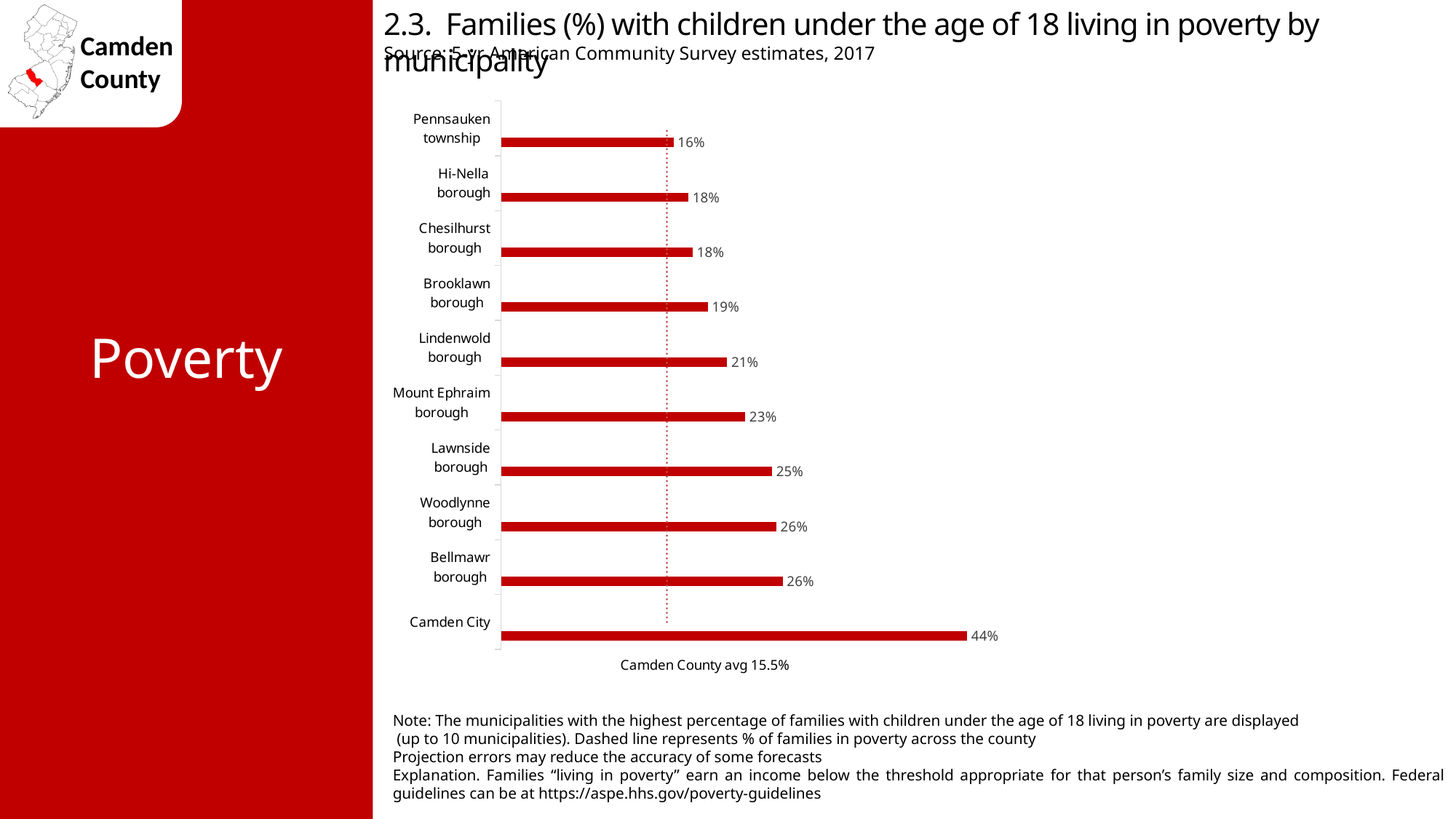
Which municipality has the lowest percentage shown on the chart? Pennsauken township What kind of chart is shown on the slide? Bar chart What is the value shown for Mount Ephraim borough? 23% What is the Camden County average shown on the chart? 15.5% How many municipalities are shown on the chart? 10 What percentage of families with children under 18 are living in poverty in Camden City? 44% What is the difference between the values for Camden City and Bellmawr borough? 18% Which municipality has the highest percentage of families with children living in poverty? Camden City Which has a higher value, Lawnside borough or Brooklawn borough? Lawnside borough What does the dashed line on the chart represent? Camden County avg 15.5% What is the value shown for Pennsauken township? 16% What is the value shown for Lindenwold borough? 21%